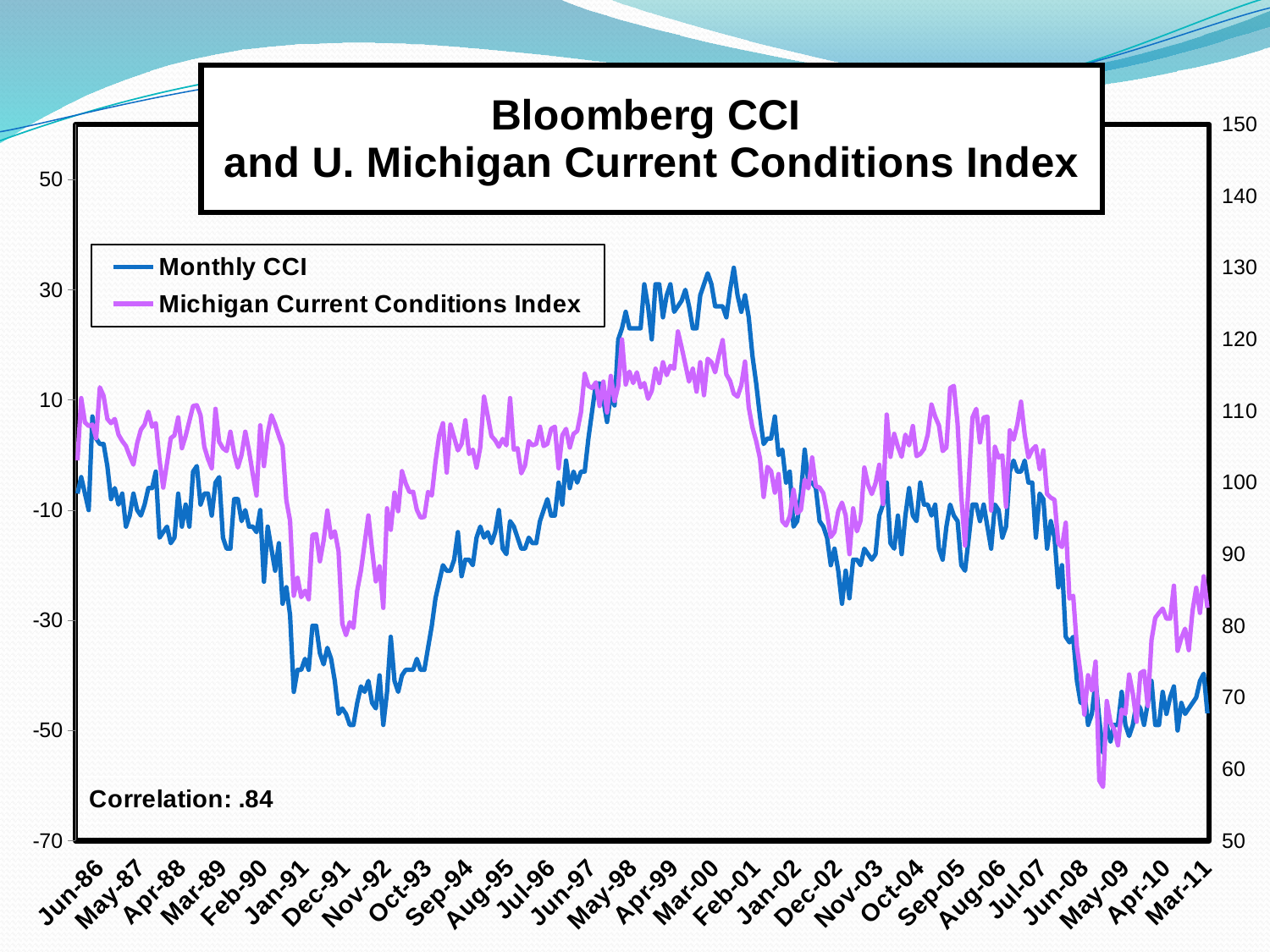
What is the title of the chart? Bloomberg CCI and U. Michigan Current Conditions Index Does the Monthly CCI rise or fall between Jun-08 and May-09? fall Around which x-axis label does the Michigan Current Conditions Index reach its lowest point? May-09 What correlation value is printed on the chart? .84 Is the Michigan Current Conditions Index value at Jun-86 greater or less than 100? greater Is the Monthly CCI value around Mar-00 greater or less than 10? greater Is the Monthly CCI value around Dec-91 greater or less than -30? less What kind of chart is shown on the slide? line chart Does the Michigan Current Conditions Index rise or fall between May-09 and Mar-11? rise How many series does the legend list? 2